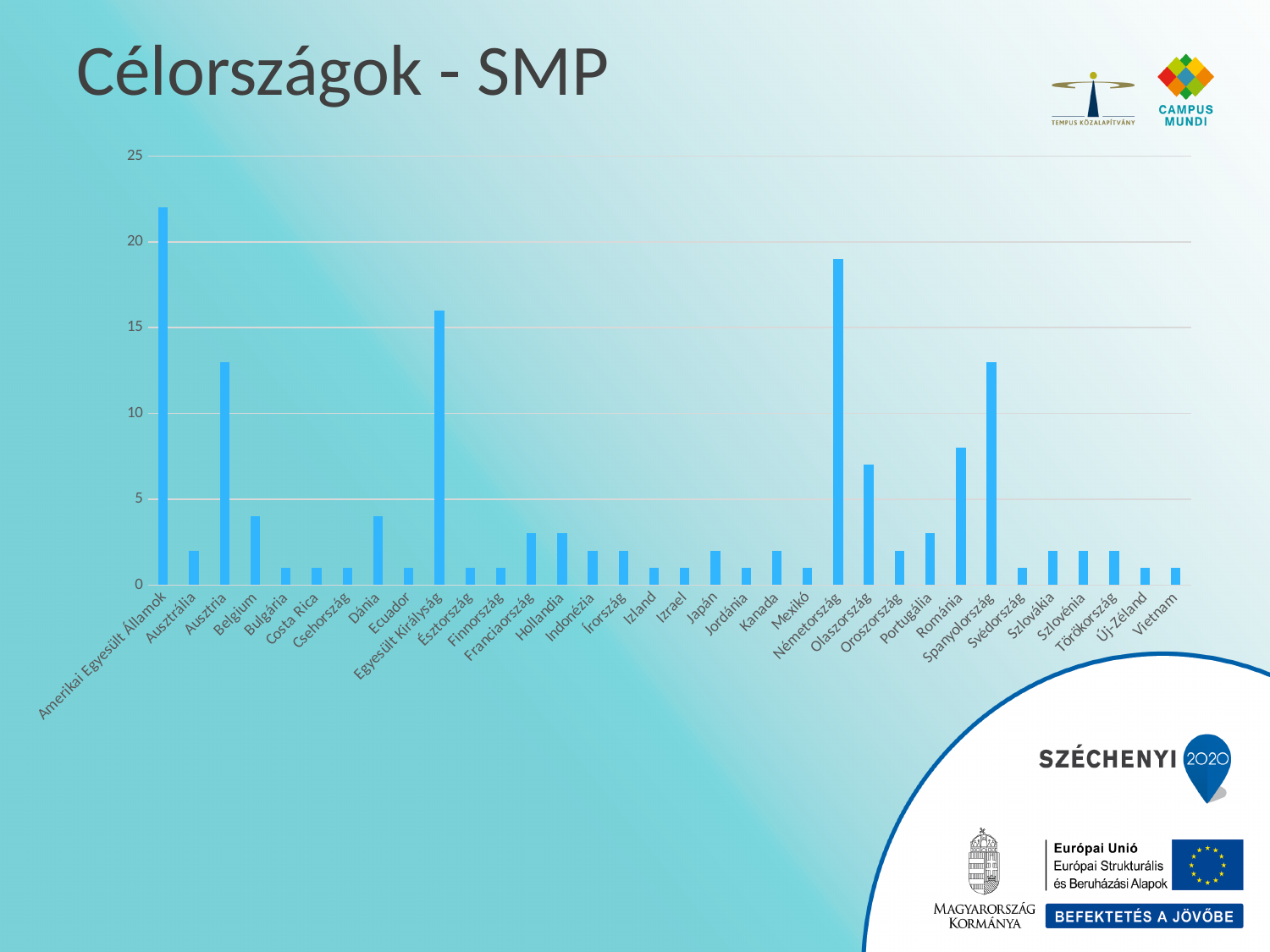
Which is larger, the value for Románia or the value for Olaszország? Románia Which is larger, the value for Németország or the value for Spanyolország? Németország Is the value for Egyesült Királyság greater or less than 20? less Is the value for Amerikai Egyesült Államok greater or less than 20? greater Which country has the highest value in the chart? Amerikai Egyesült Államok What kind of chart is shown on the slide? bar chart What is the title of the slide containing the chart? Célországok - SMP Is the value for Németország greater or less than 15? greater How many countries are shown on the x axis of the chart? 34 Which is larger, the value for Egyesült Királyság or the value for Ausztria? Egyesült Királyság